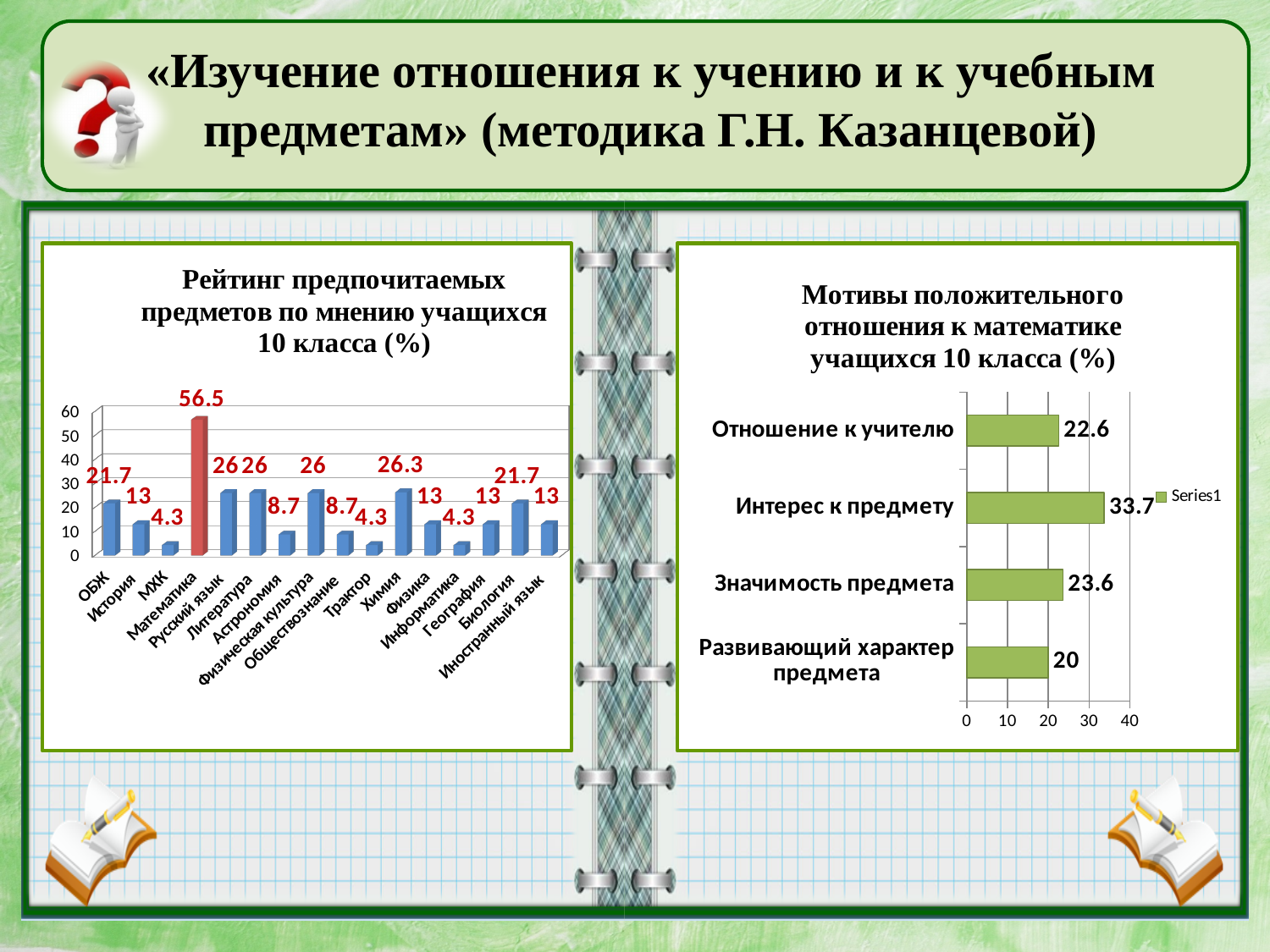
In the chart 'Рейтинг предпочитаемых предметов по мнению учащихся 10 класса (%)', which is larger: the value for Биология or the value for Физика? Биология In the chart 'Рейтинг предпочитаемых предметов по мнению учащихся 10 класса (%)', which subject has the highest value? Математика In the chart 'Рейтинг предпочитаемых предметов по мнению учащихся 10 класса (%)', how many subjects are shown on the x axis? 16 In the chart 'Рейтинг предпочитаемых предметов по мнению учащихся 10 класса (%)', which bar is coloured red instead of blue? Математика In the chart 'Мотивы положительного отношения к математике учащихся 10 класса (%)', how many series does the legend list? 1 In the chart 'Рейтинг предпочитаемых предметов по мнению учащихся 10 класса (%)', what is the value for Математика? 56.5 In the chart 'Мотивы положительного отношения к математике учащихся 10 класса (%)', what is the value for Интерес к предмету? 33.7 What kind of chart is 'Мотивы положительного отношения к математике учащихся 10 класса (%)'? Bar chart In the chart 'Мотивы положительного отношения к математике учащихся 10 класса (%)', which category has the lowest value? Развивающий характер предмета In the chart 'Мотивы положительного отношения к математике учащихся 10 класса (%)', what is the difference between the values for Интерес к предмету and Отношение к учителю? 11.1 In the chart 'Рейтинг предпочитаемых предметов по мнению учащихся 10 класса (%)', what is the value for Химия? 26.3 In the chart 'Рейтинг предпочитаемых предметов по мнению учащихся 10 класса (%)', what is the difference between the values for Математика and ОБЖ? 34.8